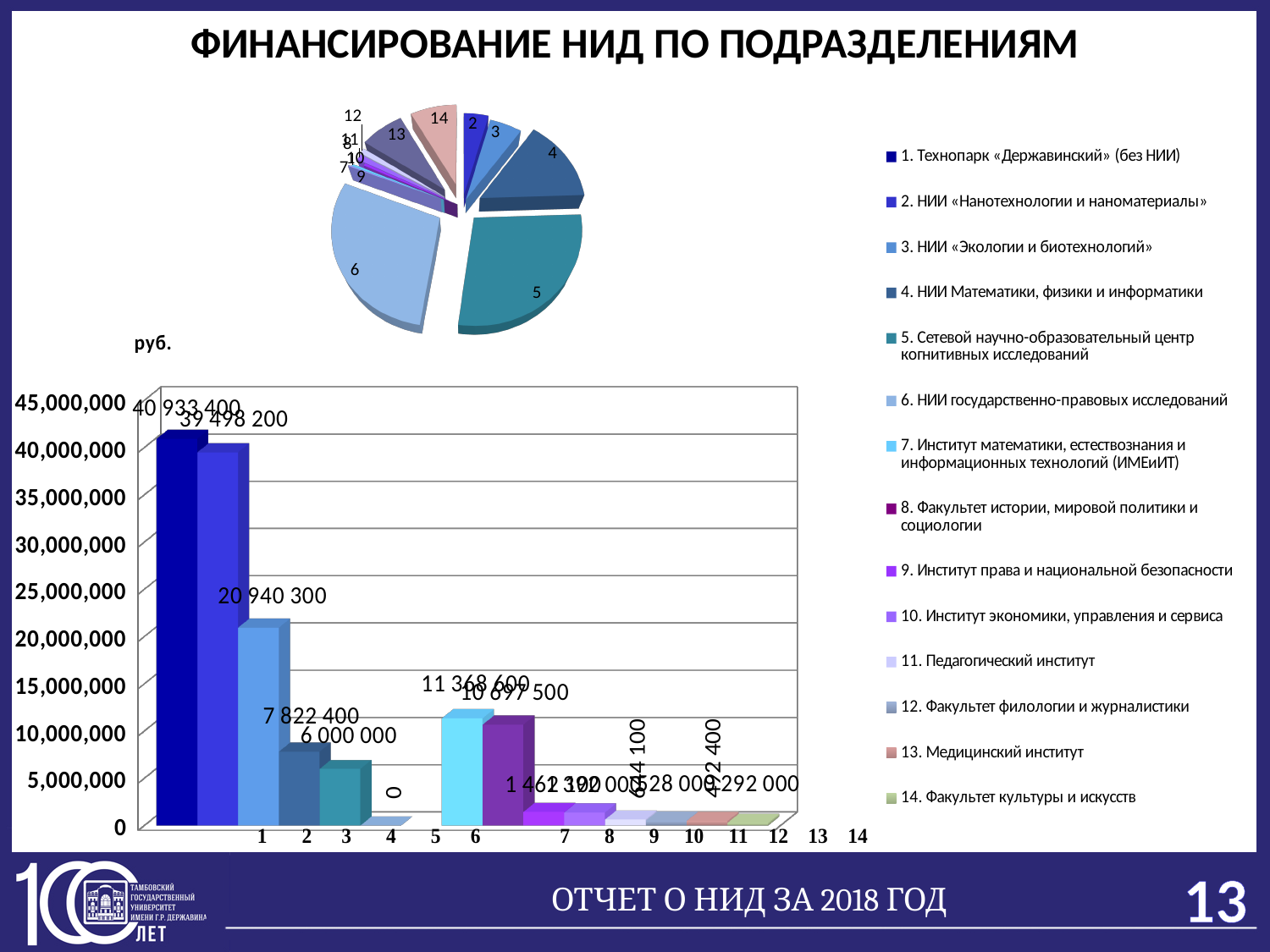
What kind of chart is the upper chart on the slide? pie chart How many entries does the legend list? 14 What kind of chart is the lower chart on the slide? bar chart What is the title of the slide's charts? ФИНАНСИРОВАНИЕ НИД ПО ПОДРАЗДЕЛЕНИЯМ In the bar chart, what is the difference between the two tallest bars (40 933 400 and 39 498 200)? 1 435 200 What unit is indicated above the bar chart's vertical axis? руб. In the bar chart, what is the highest value shown? 40 933 400 In the bar chart, how many bars are plotted? 14 In the bar chart, what is the lowest value shown? 0 In the bar chart, is the value 20 940 300 greater or less than 20,000,000 on the axis? greater